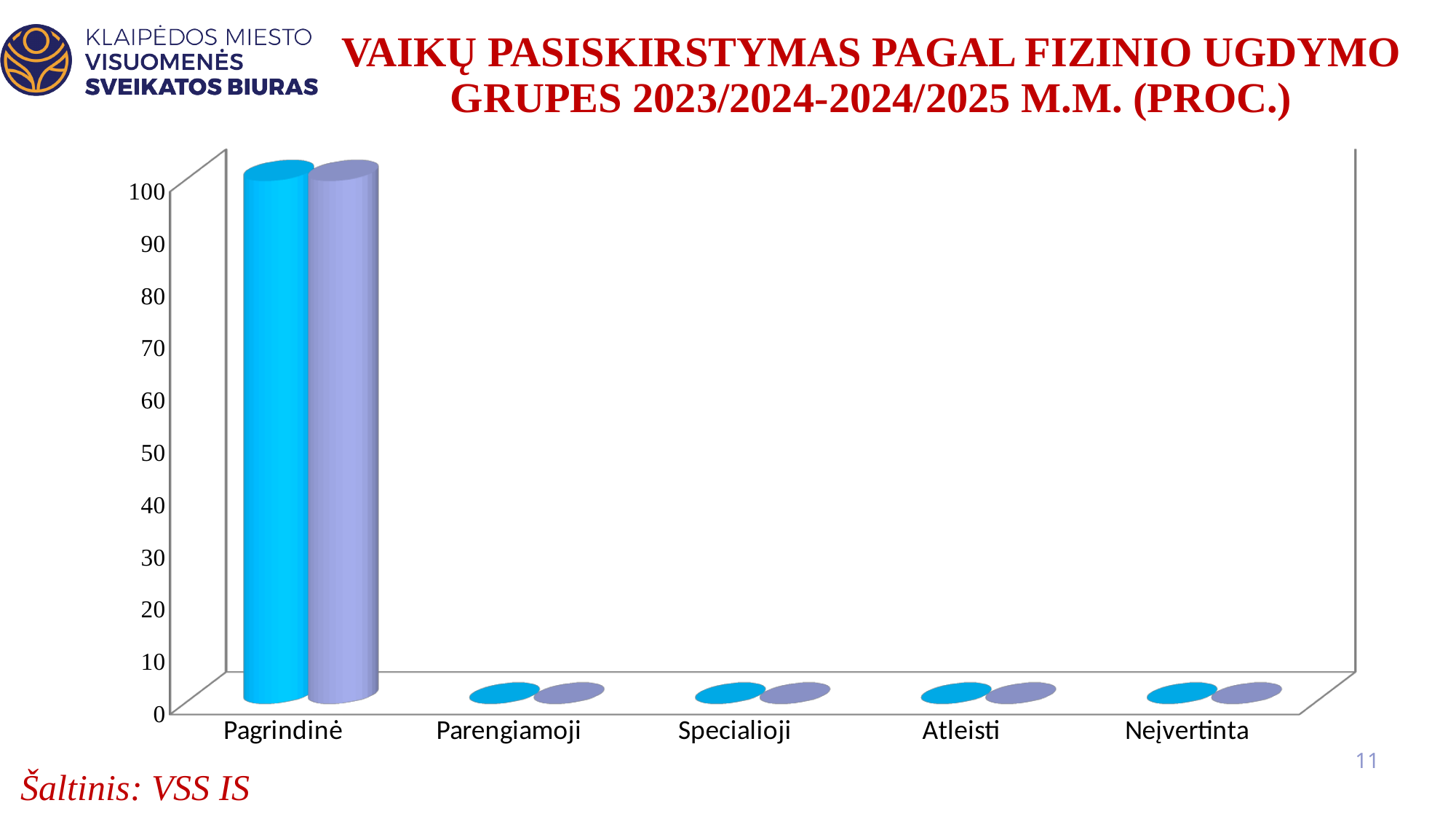
Is the value for Specialioji greater or less than 10? less What is the highest tick value shown on the vertical axis of the chart? 100 Is the value for Pagrindinė greater or less than 90? greater Is the value for Atleisti greater or less than 20? less What source is cited below the chart? VSS IS How many categories are shown on the x axis of the chart? 5 Which category has the highest values in the chart? Pagrindinė Which is larger, the value for Atleisti or the value for Pagrindinė? Pagrindinė What kind of chart is shown on the slide? bar chart Which is larger, the value for Pagrindinė or the value for Parengiamoji? Pagrindinė